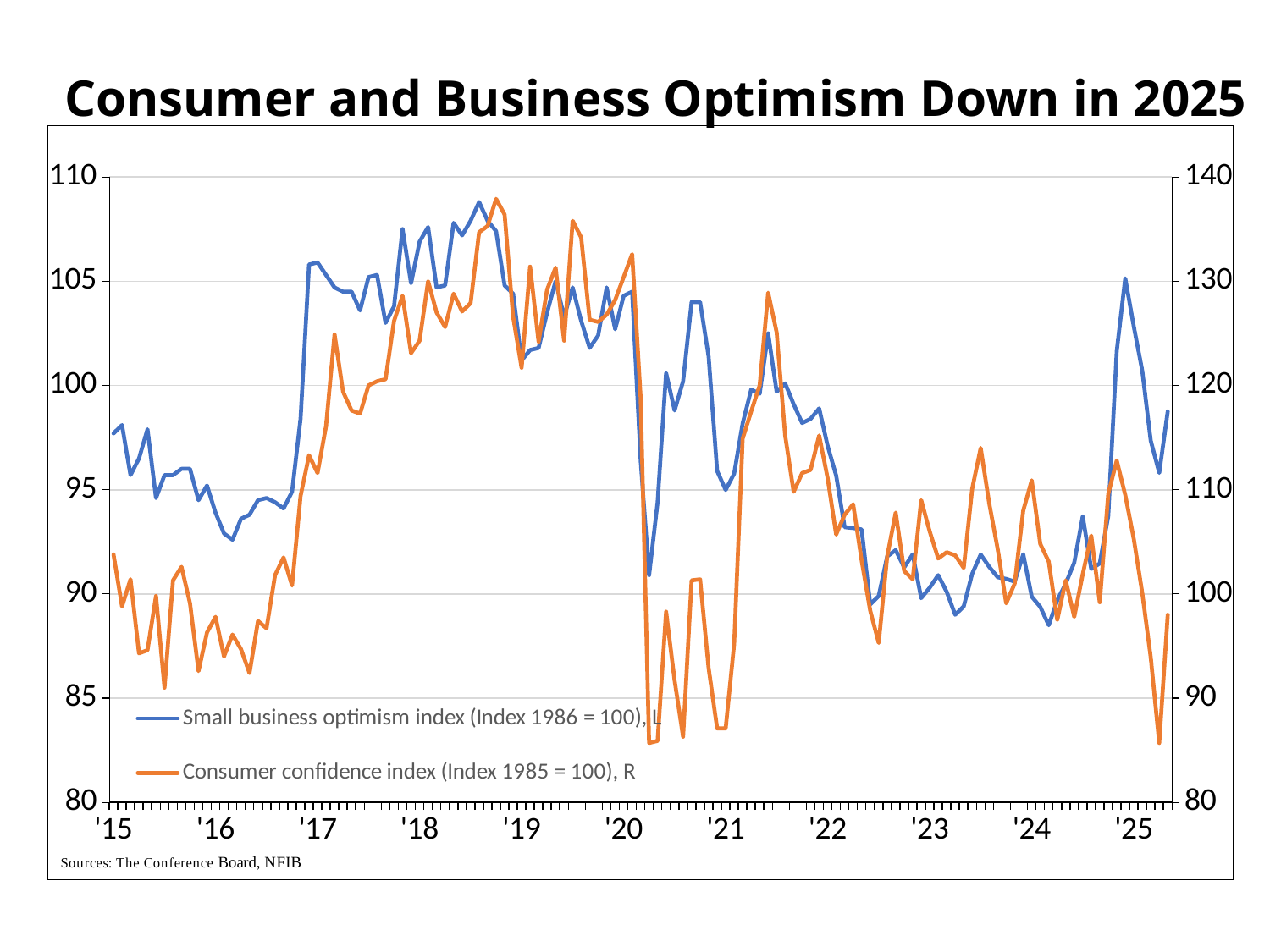
Does the Small business optimism index rise or fall between '16 and '17? rise Is the Consumer confidence index higher in '19 or in '15? '19 Is the Small business optimism index at the start of '15 greater or less than 95? greater Is the Consumer confidence index at its peak in '19 greater or less than 130? greater Is the Consumer confidence index at its lowest point in '25 greater or less than 90? less What sources are cited below the chart? The Conference Board, NFIB What is the title of the chart? Consumer and Business Optimism Down in 2025 What kind of chart is shown on the slide? line chart How many series does the legend list? 2